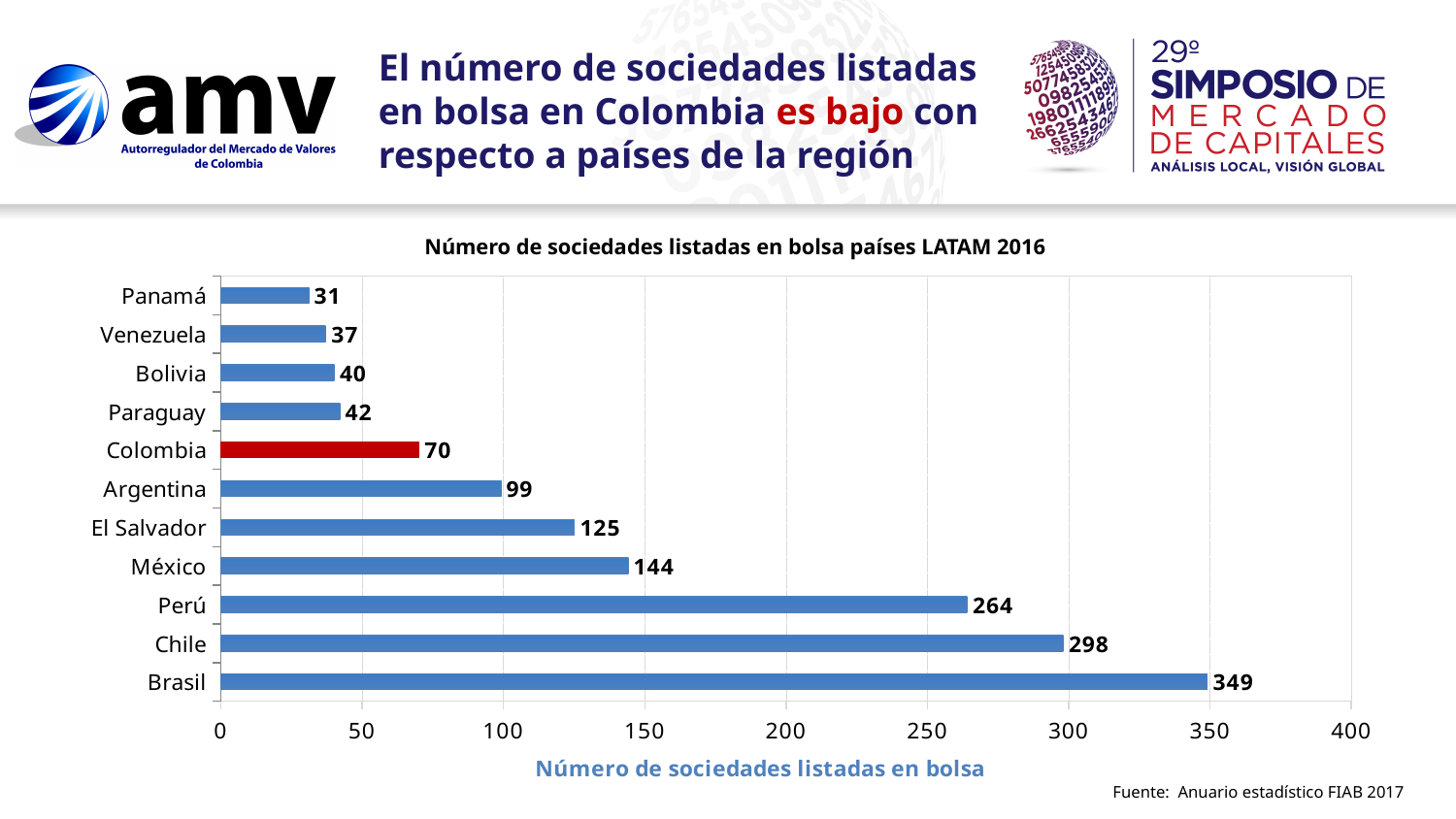
What is the value shown for Perú? 264 Is the value for Chile greater or less than 250? greater What is the difference between the values for Brasil and Chile? 51 What is the number of listed companies for Colombia? 70 Which country's bar is highlighted in red? Colombia Which country has the highest number of listed companies? Brasil What is the title of the chart? Número de sociedades listadas en bolsa países LATAM 2016 What is the difference between the values for México and Colombia? 74 Which country has the lowest number of listed companies? Panamá Which has a larger value, Argentina or El Salvador? El Salvador What kind of chart is shown on the slide? Bar chart How many countries are shown in the chart? 11